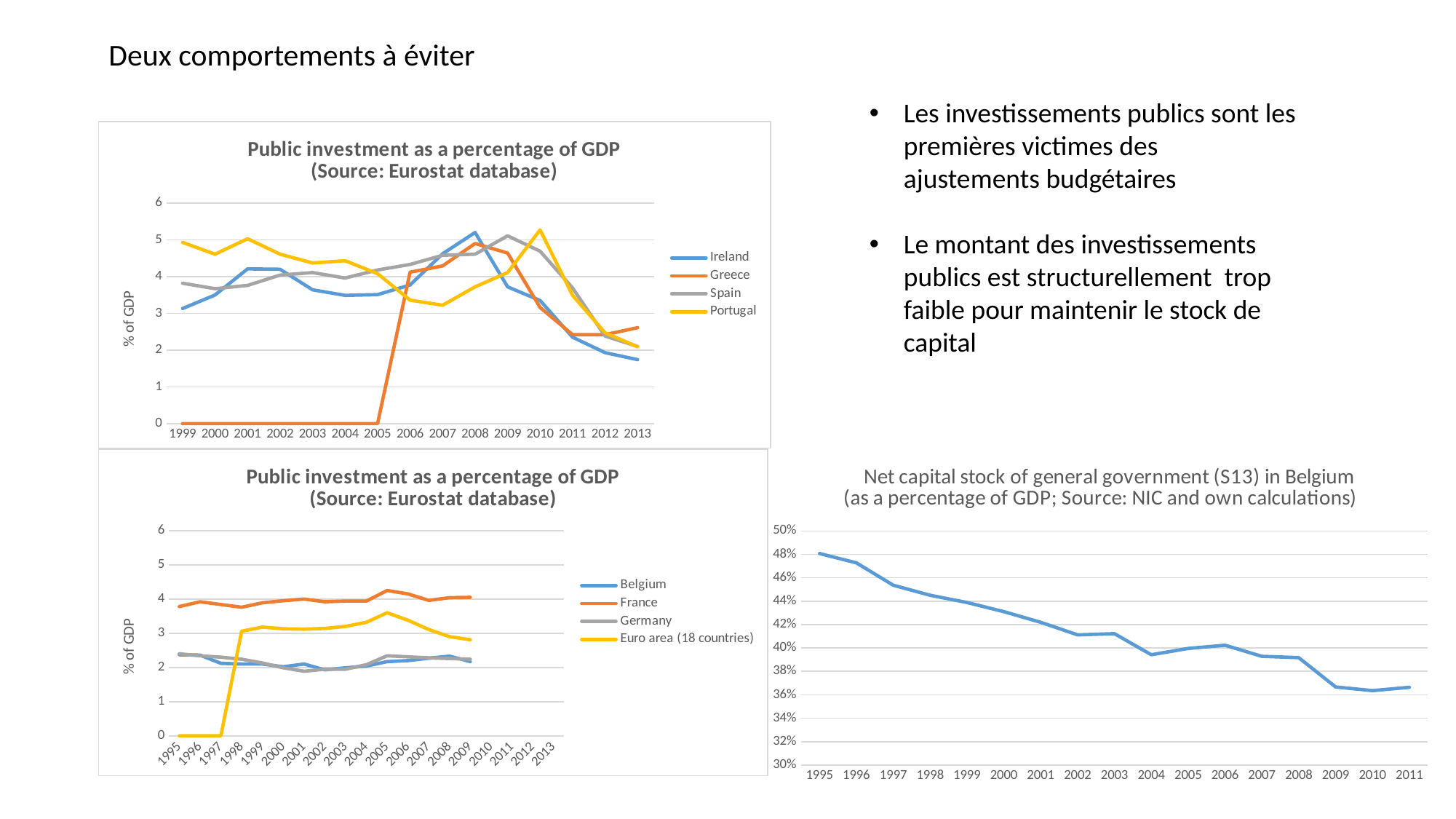
What kind of chart is the top-left chart (Public investment as a percentage of GDP, Ireland/Greece/Spain/Portugal)? Line chart In the bottom-left chart, is the value for Euro area (18 countries) in 2005 greater or less than 3? greater How many years are shown on the x axis of the chart titled 'Net capital stock of general government (S13) in Belgium'? 17 In the top-left chart, is the value for Ireland in 2008 greater or less than 5? greater In the chart titled 'Net capital stock of general government (S13) in Belgium', is the value for 2011 greater or less than 38%? less In the chart titled 'Net capital stock of general government (S13) in Belgium', do the values generally rise or fall from 1995 to 2011? Fall In the top-left chart, which is larger in 2013: Greece or Ireland? Greece Which series does the legend of the bottom-left chart list? Belgium, France, Germany, Euro area (18 countries) How many years are shown on the x axis of the top-left chart? 15 In the top-left chart, what is the value for Greece in 2003? 0 How many series does the legend of the top-left chart list? 4 In the top-left chart, which series has the highest value in 2010? Portugal